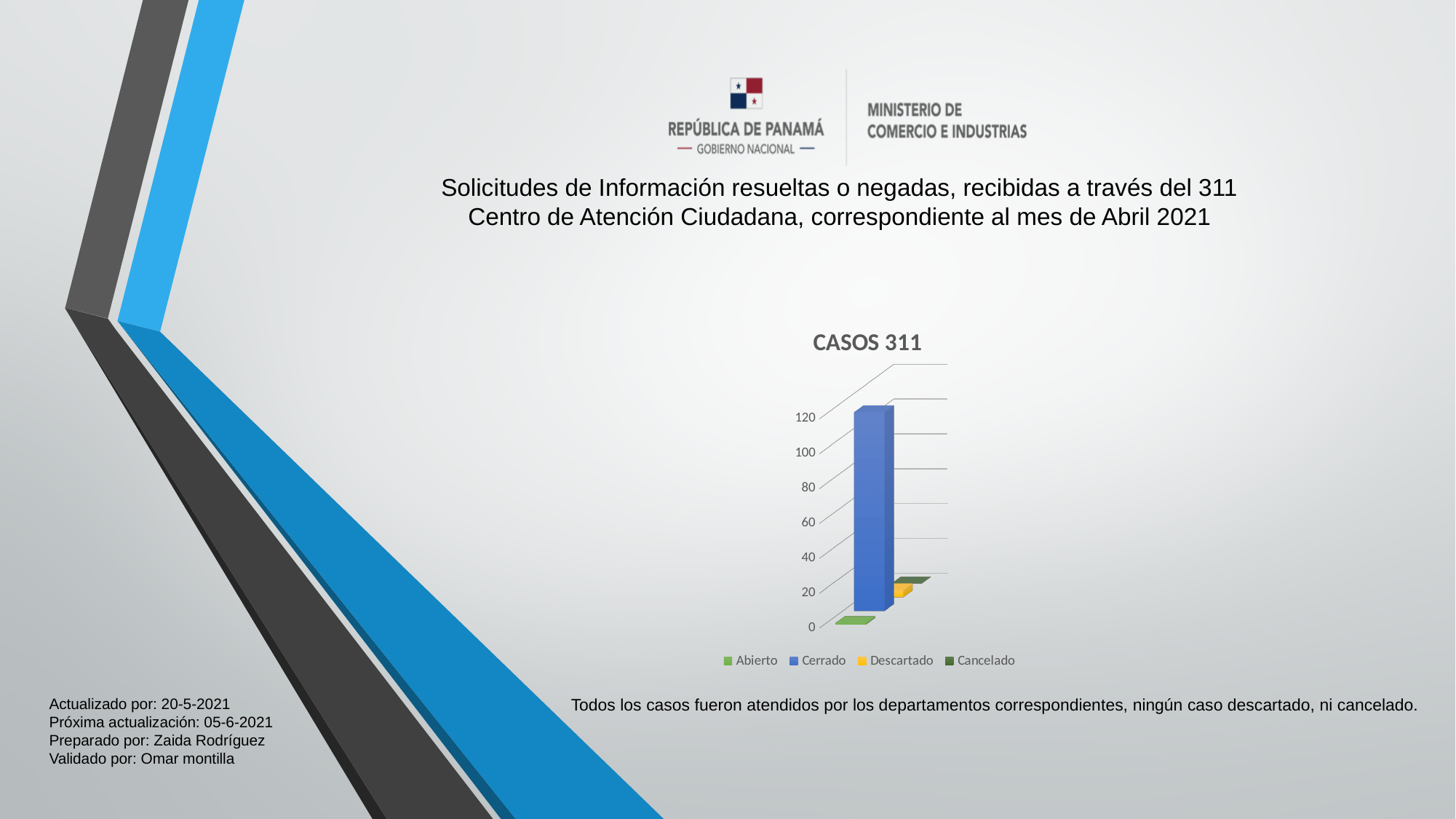
Which series is shown in blue in the CASOS 311 chart? Cerrado Is the value for Cerrado greater or less than 80? greater How many series does the legend of the CASOS 311 chart list? 4 What is the title of the chart on the slide? CASOS 311 What is the highest tick value shown on the vertical axis of the CASOS 311 chart? 120 What kind of chart is shown under the title CASOS 311? bar chart Is the value for Descartado greater or less than 40? less Which series has the highest value in the CASOS 311 chart? Cerrado Is the value for Cerrado greater or less than 100? greater Which is larger, the value for Cerrado or the value for Cancelado? Cerrado Which is larger, the value for Cerrado or the value for Abierto? Cerrado